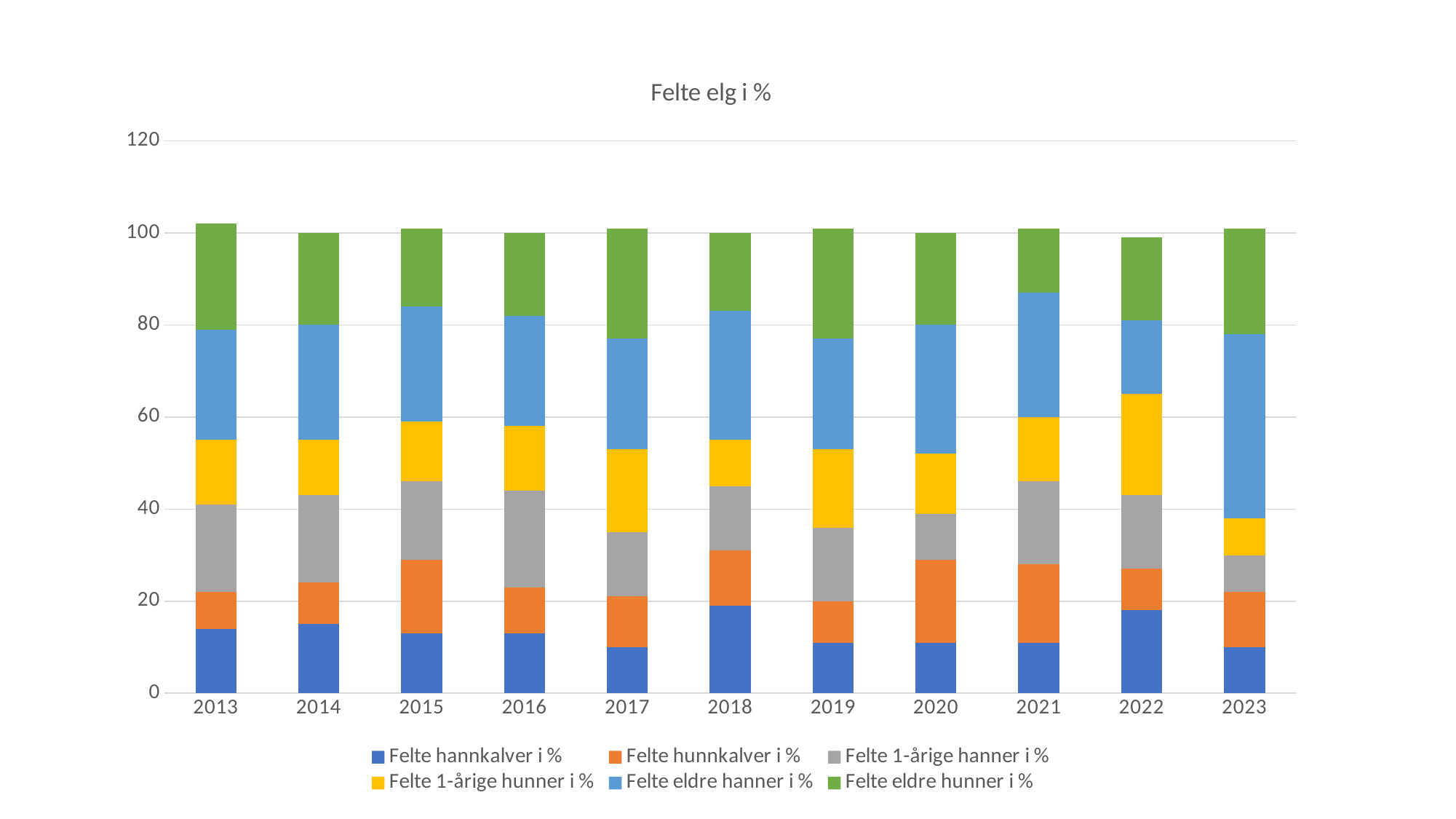
In which year is the Felte eldre hanner i % segment the largest? 2023 Which colour represents Felte eldre hunner i % in the chart? Green How many series does the legend list? 6 In which year is the Felte 1-årige hanner i % segment the smallest? 2023 Which is larger, Felte hannkalver i % in 2018 or in 2017? 2018 Which is larger, Felte 1-årige hunner i % in 2022 or in 2023? 2022 Is the value for Felte hannkalver i % in 2018 greater or less than 10? greater What is the title of the chart? Felte elg i % What kind of chart is shown on the slide? Stacked bar chart Which is larger, Felte eldre hanner i % in 2023 or in 2022? 2023 Is the value for Felte hannkalver i % in 2017 greater or less than 20? less How many years are shown on the x axis? 11